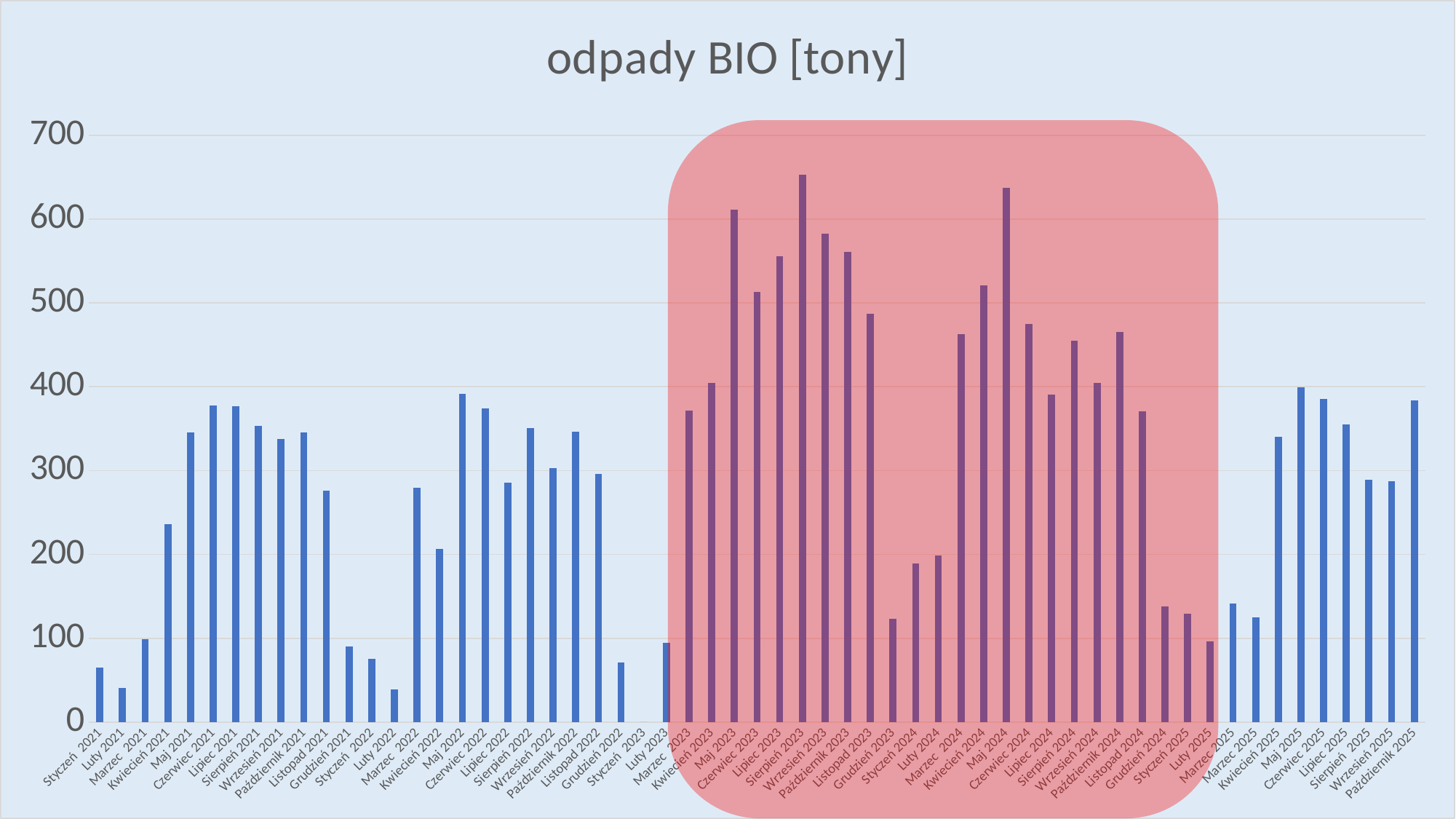
Is the value for Luty 2025 greater or less than 200? less Is the value for Styczeń 2021 greater or less than 100? less Which month has the highest value in the chart? Sierpień 2023 Do the values rise or fall from Sierpień 2023 to Grudzień 2023? fall Which is larger, the value for Maj 2024 or the value for Maj 2023? Maj 2024 Is the value for Maj 2024 greater or less than 600? greater Which is larger, the value for Sierpień 2023 or the value for Czerwiec 2023? Sierpień 2023 What is the title of the chart? odpady BIO [tony] What kind of chart is shown on the slide? bar chart